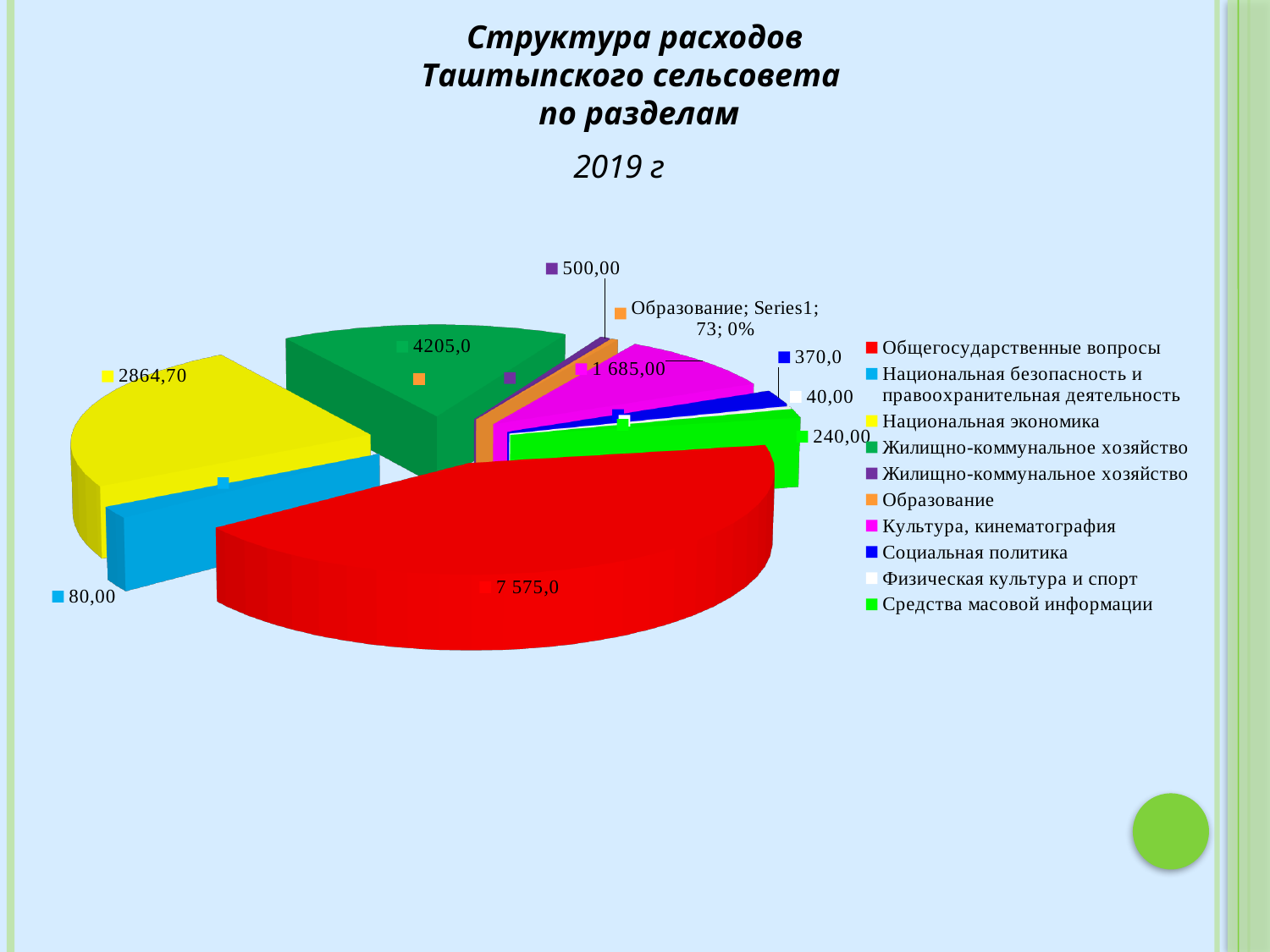
Which category has the largest slice of the pie? Общегосударственные вопросы What is the value shown for Общегосударственные вопросы? 7 575,0 Which is larger, the value for Национальная экономика or the value for Культура, кинематография? Национальная экономика What is the value shown for Национальная экономика? 2864,70 What is the value shown for Культура, кинематография? 1 685,00 What kind of chart is shown on the slide? Pie chart What is the value shown for Социальная политика? 370,0 What is the value shown for Национальная безопасность и правоохранительная деятельность? 80,00 How many entries does the legend list? 10 What is the difference between the value for Социальная политика and the value for Средства масовой информации? 130,0 Which category has the smallest value shown? Физическая культура и спорт What is the value shown for Средства масовой информации? 240,00